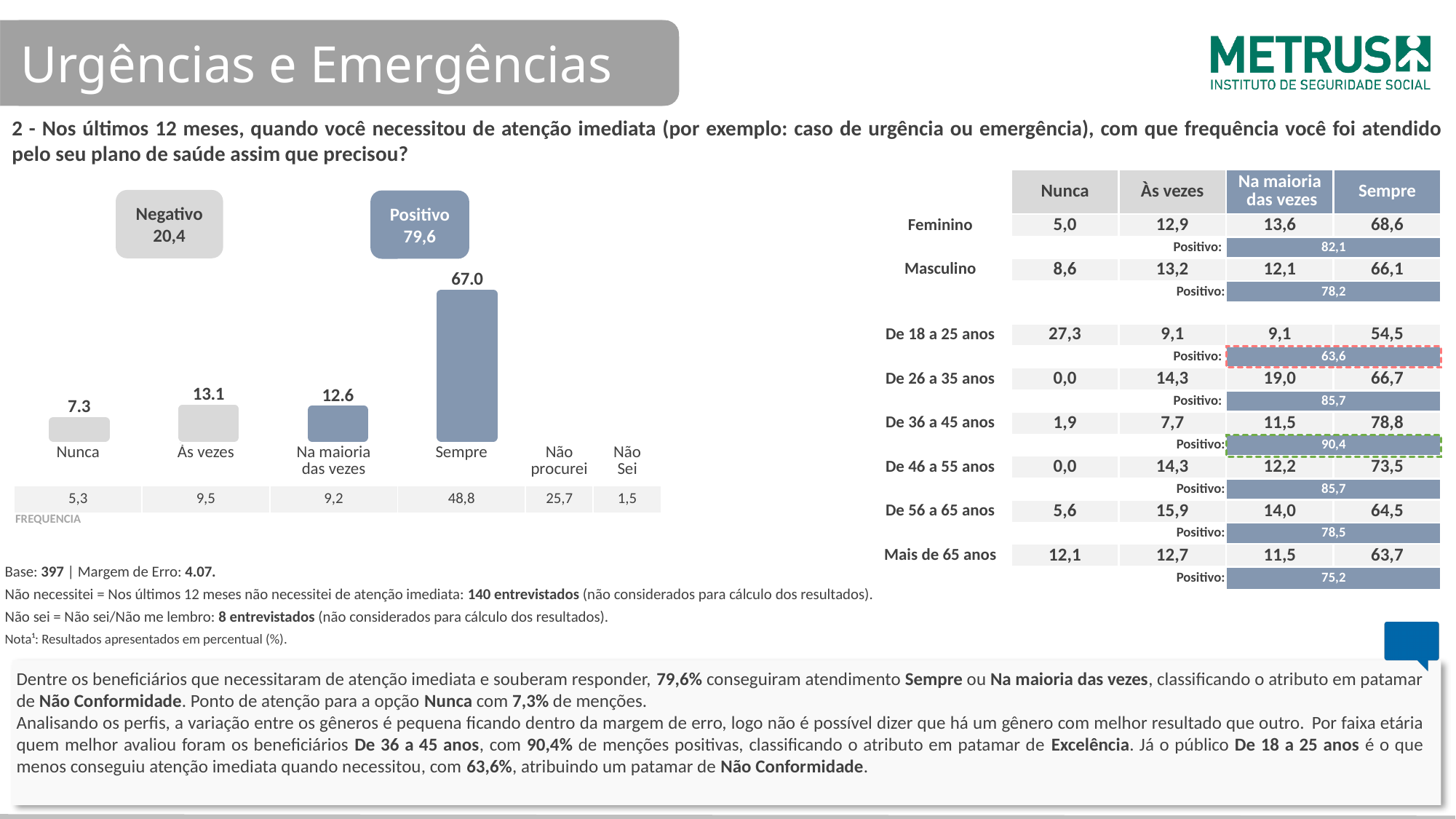
Which category has the lowest bar in the chart? Nunca How many bars are plotted in the chart? 4 What is the difference between the Sempre bar and the Nunca bar? 59.7 What is the value of the Na maioria das vezes bar in the chart? 12.6 What kind of chart is shown on the slide? bar chart What is the value of the Sempre bar in the chart? 67.0 What is the value of the Às vezes bar in the chart? 13.1 What is the value of the Nunca bar in the chart? 7.3 Which category has the highest bar in the chart? Sempre Which is larger in the chart, the Sempre bar or the Nunca bar? Sempre What is the difference between the Sempre bar and the Às vezes bar? 53.9 What value is shown in the Positivo box above the chart? 79,6